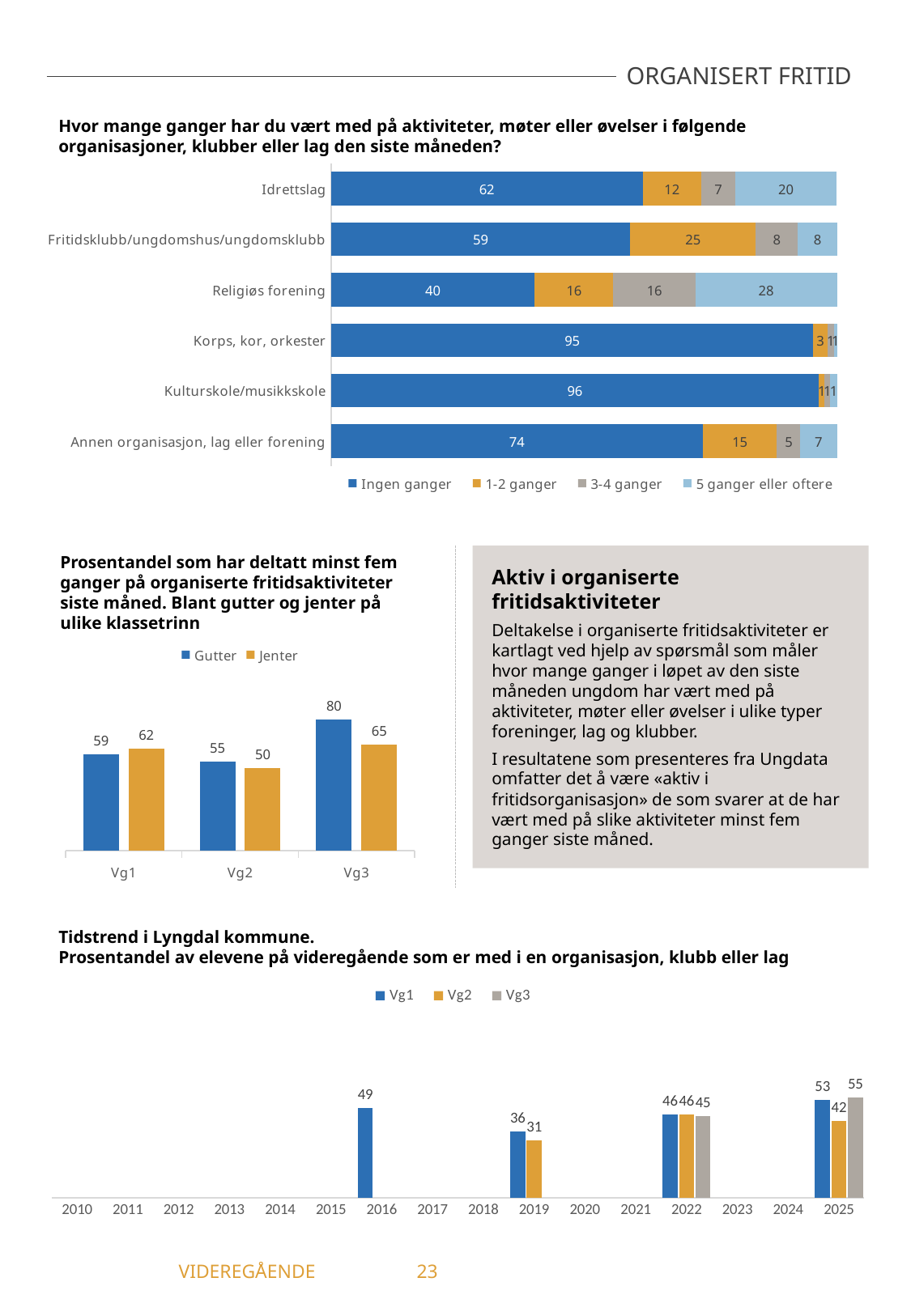
In the top chart, which category has the highest 'Ingen ganger' value? Kulturskole/musikkskole In the middle-left chart, what is the value for Gutter at Vg3? 80 In the top chart, what is the value for '5 ganger eller oftere' for Religiøs forening? 28 In the top chart, how many series does the legend list? 4 In the middle-left chart, which is larger at Vg2, Gutter or Jenter? Gutter In the top chart, what percentage of respondents answered 'Ingen ganger' for Idrettslag? 62 In the bottom chart, what is the value for Vg1 in 2016? 49 In the middle-left chart, what is the difference between Jenter and Gutter at Vg1? 3 In the top chart, what is the difference between the '1-2 ganger' values for Fritidsklubb/ungdomshus/ungdomsklubb and Idrettslag? 13 In the top chart, how many categories are shown? 6 In the bottom chart, which series has the highest value in 2025? Vg3 What type of chart is the bottom chart? Bar chart